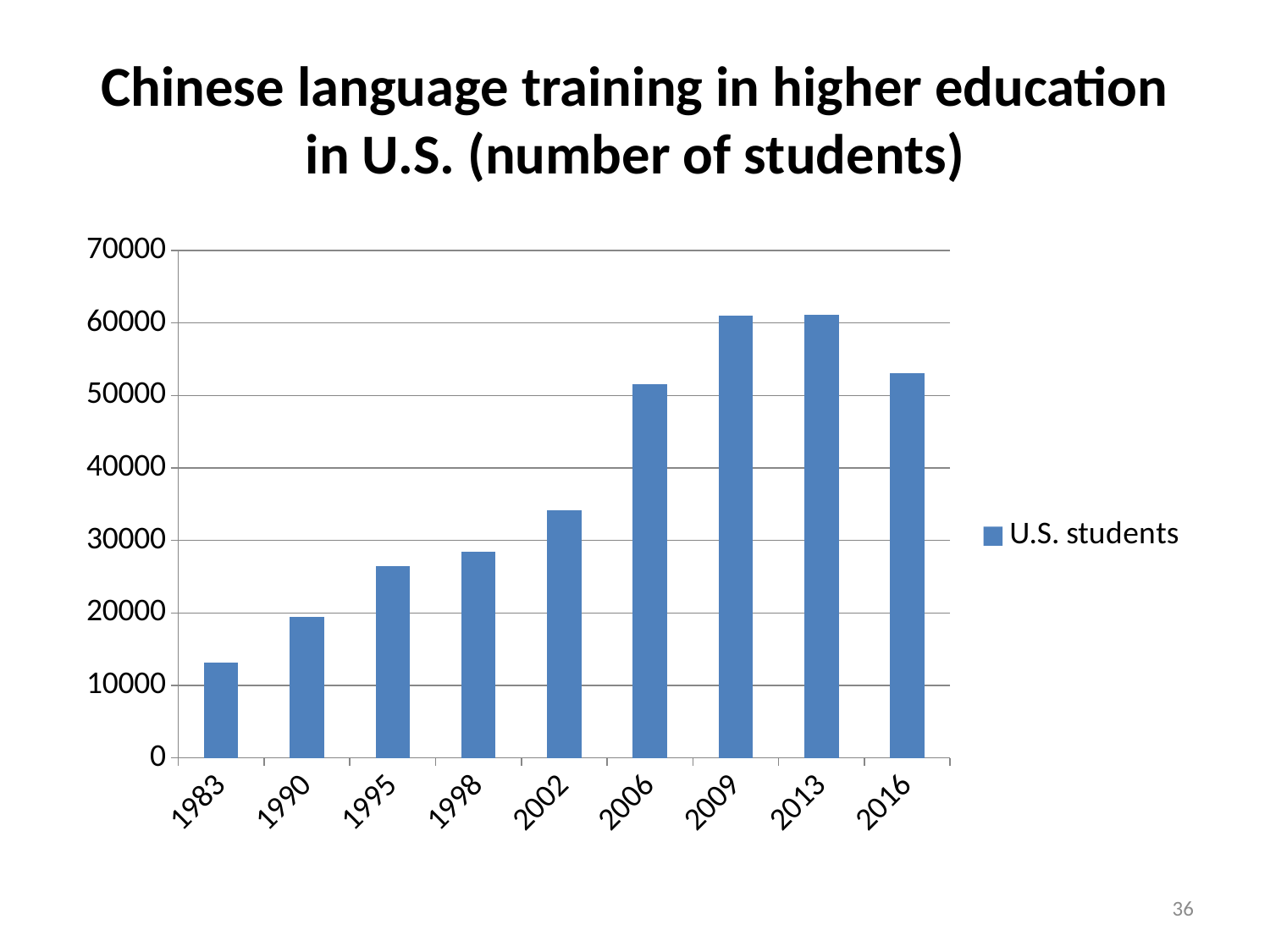
Which year has the larger value, 1990 or 1995? 1995 Do the values generally rise or fall from 1983 to 2009? rise Is the value for 2016 greater or less than 60000? less What is the name of the series shown in the legend? U.S. students Is the value for 1983 greater or less than 20000? less Is the value for 2002 greater or less than 30000? greater Which year has the lowest number of U.S. students? 1983 Which year has the larger value, 2002 or 2006? 2006 How many years are shown on the x axis of the chart? 9 What kind of chart is shown on the slide? bar chart How many series does the legend list? 1